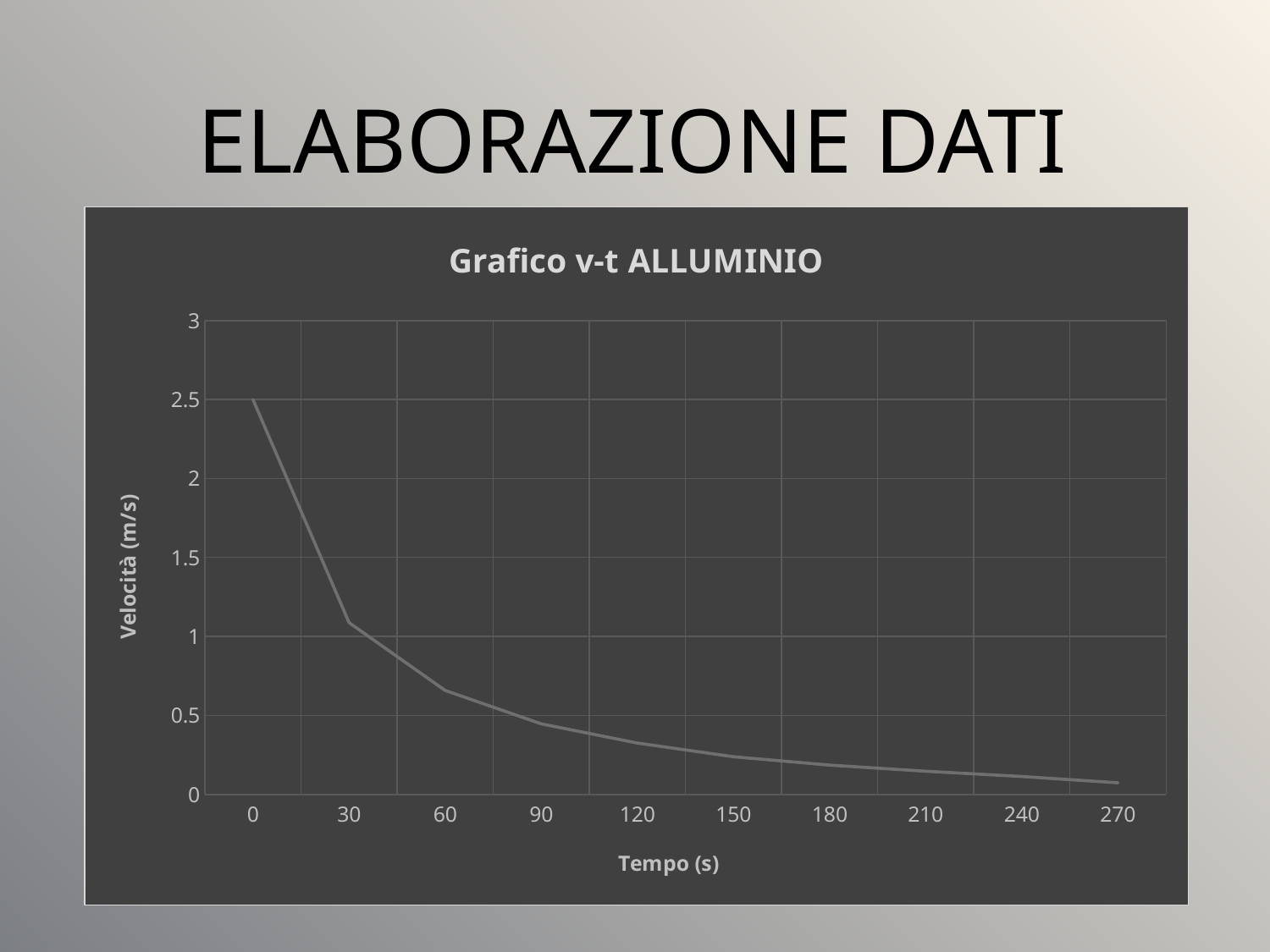
What kind of chart is shown on the slide? line chart Which is larger, the velocity at time 30 or the velocity at time 90? time 30 Is the velocity at time 60 greater or less than 0.5? greater Is the velocity at time 0 greater or less than 2? greater Is the velocity at time 270 greater or less than 0.5? less How many time points are plotted on the line? 10 Do the values rise or fall as time increases along the x axis? fall What is the title of the chart? Grafico v-t ALLUMINIO At which time (s) is the velocity highest? 0 At which time (s) is the velocity lowest? 270 What is the label of the y axis? Velocità (m/s)